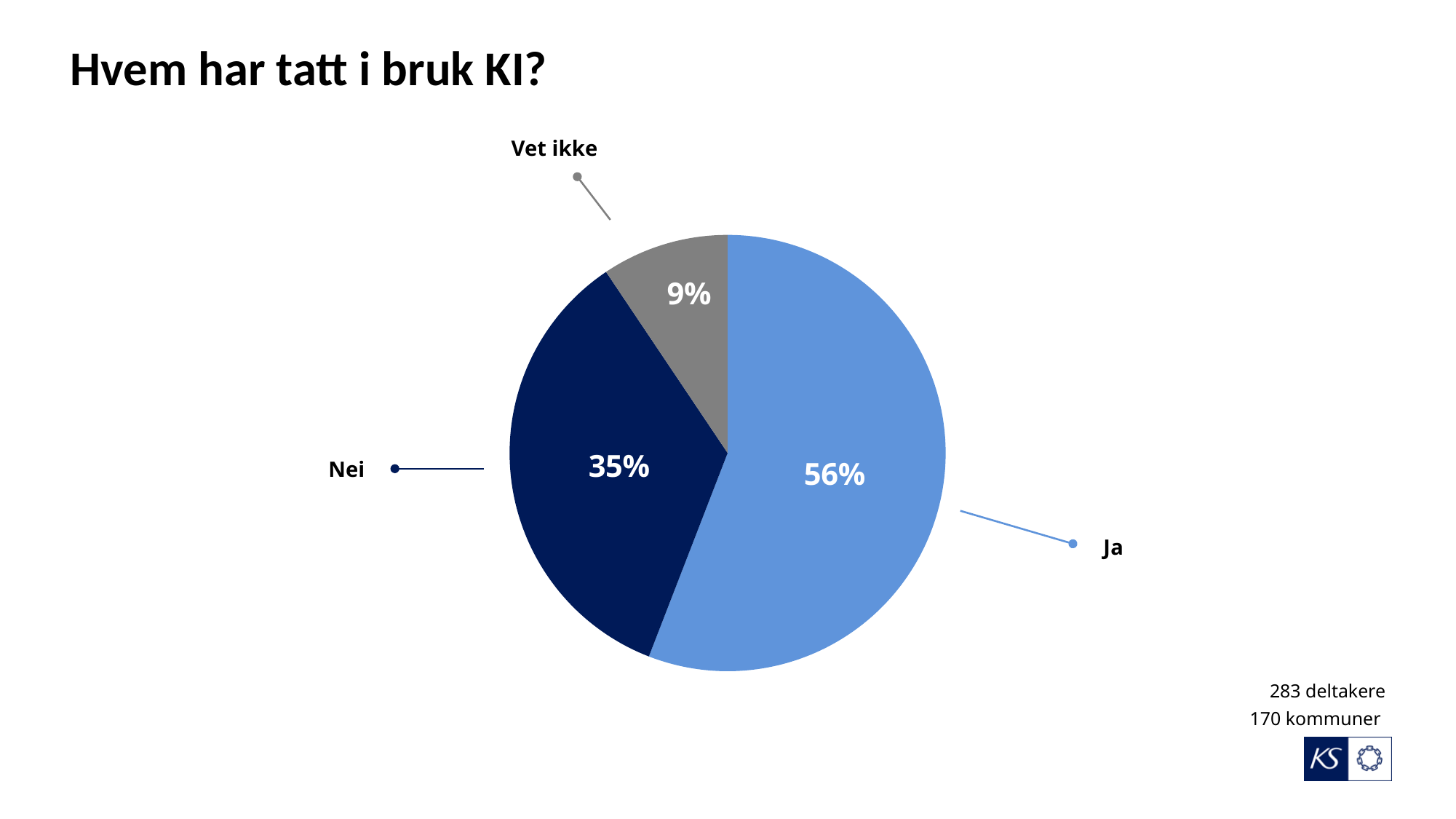
What kind of chart is shown on the slide? Pie chart What is the title of the slide? Hvem har tatt i bruk KI? What is the value shown for "Nei"? 35% What is the value shown for "Vet ikke"? 9% How many slices does the pie chart have? 3 What is the combined share of "Nei" and "Vet ikke"? 44% What colour is the "Vet ikke" slice? Grey What is the difference in percentage points between "Ja" and "Nei"? 21 Which category has the largest slice of the pie? Ja Which is larger, the "Nei" slice or the "Vet ikke" slice? Nei What share of the pie does the "Ja" slice represent? 56% Which category has the smallest slice of the pie? Vet ikke